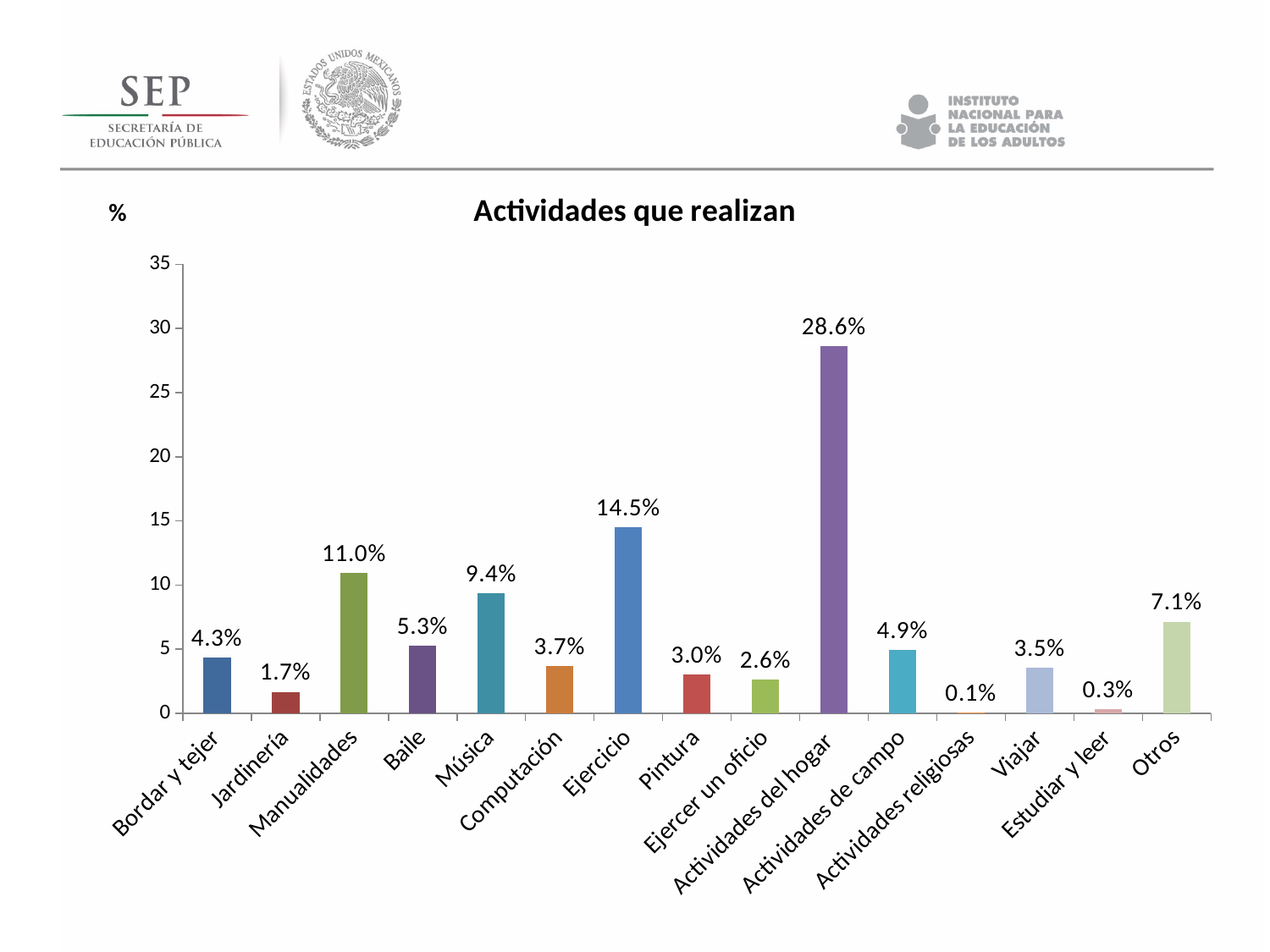
What is the value for Estudiar y leer? 0.3% How many categories are shown on the x axis? 15 What is the difference between the values for Actividades del hogar and Ejercicio? 14.1% Which category has the lowest value? Actividades religiosas Which category has the highest value? Actividades del hogar Is the value for Otros greater or less than 5? greater What kind of chart is shown on the slide? bar chart What is the value for Actividades del hogar? 28.6% What is the difference between the values for Manualidades and Música? 1.6% What is the title of the chart? Actividades que realizan What is the value for Ejercicio? 14.5% Which is larger, the value for Baile or the value for Computación? Baile